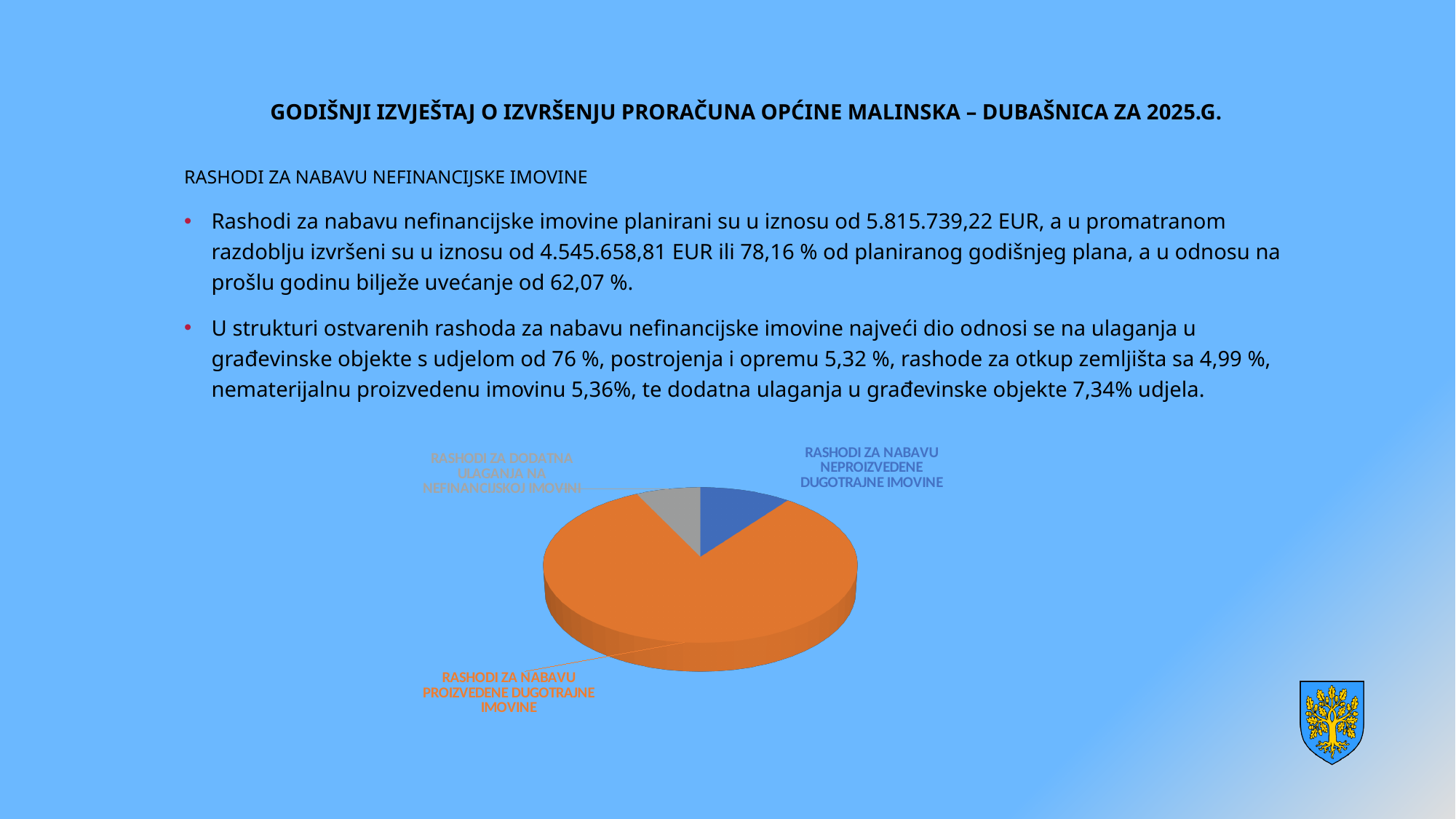
What colour is the slice for RASHODI ZA NABAVU NEPROIZVEDENE DUGOTRAJNE IMOVINE? blue How many slices does the pie chart have? 3 Does the slice for RASHODI ZA NABAVU PROIZVEDENE DUGOTRAJNE IMOVINE take up more or less than half of the pie? more Which category has the largest slice in the pie chart? RASHODI ZA NABAVU PROIZVEDENE DUGOTRAJNE IMOVINE Which slice is larger: RASHODI ZA NABAVU PROIZVEDENE DUGOTRAJNE IMOVINE or RASHODI ZA NABAVU NEPROIZVEDENE DUGOTRAJNE IMOVINE? RASHODI ZA NABAVU PROIZVEDENE DUGOTRAJNE IMOVINE Which slice is larger: RASHODI ZA DODATNA ULAGANJA NA NEFINANCIJSKOJ IMOVINI or RASHODI ZA NABAVU PROIZVEDENE DUGOTRAJNE IMOVINE? RASHODI ZA NABAVU PROIZVEDENE DUGOTRAJNE IMOVINE What colour is the slice for RASHODI ZA NABAVU PROIZVEDENE DUGOTRAJNE IMOVINE? orange What kind of chart is shown on the slide? pie chart